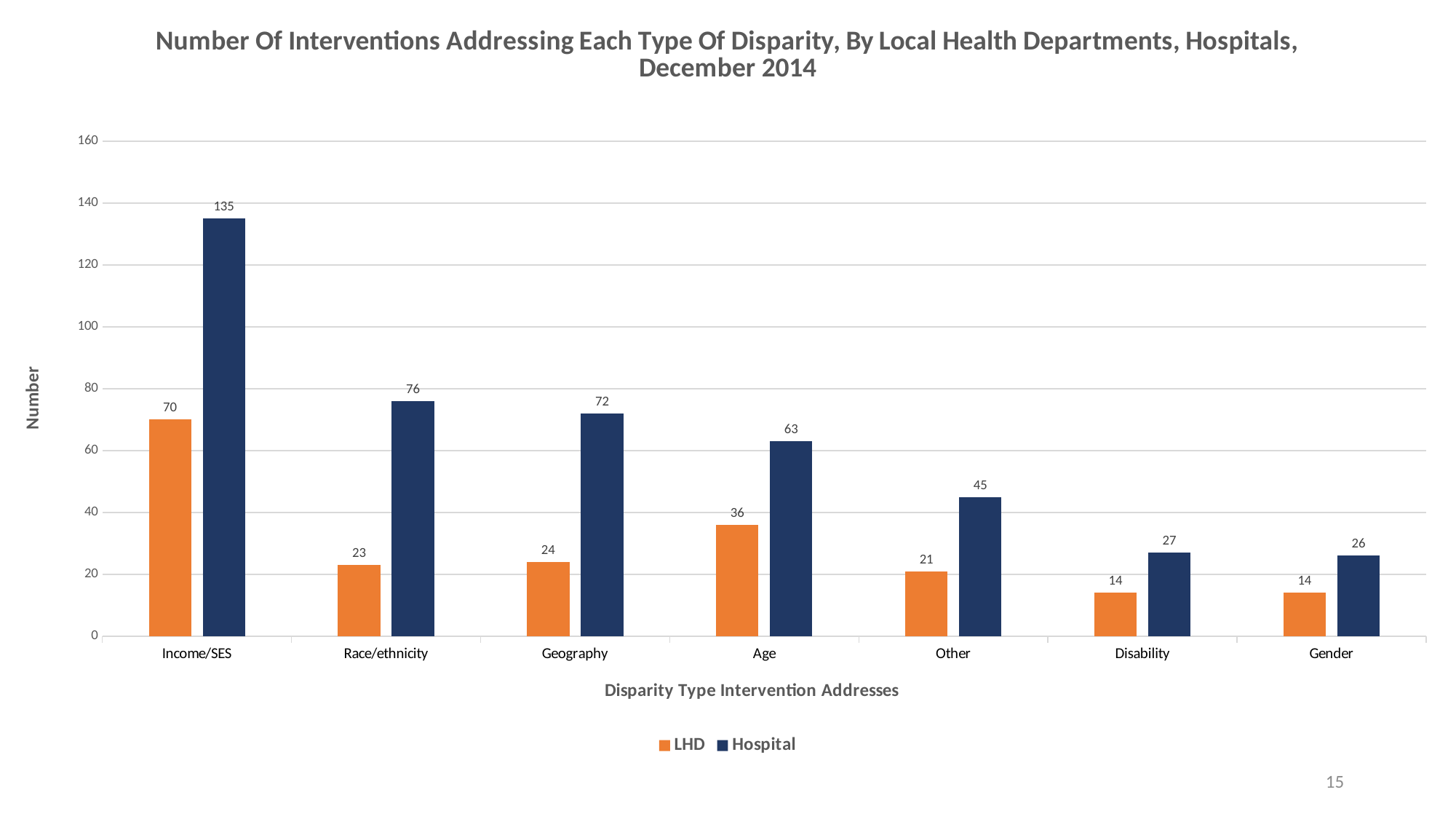
Is the Hospital value for Age greater or less than 60? greater How many series does the legend list? 2 What is the difference between the Hospital and LHD values for Income/SES? 65 What is the LHD value for Age? 36 Which disparity type has the lowest Hospital value? Gender What kind of chart is shown on the slide? bar chart Which disparity type has the highest Hospital value? Income/SES What is the difference between the Hospital values for Race/ethnicity and Geography? 4 What is the LHD value for Disability? 14 Which is larger, the LHD value for Geography or the LHD value for Race/ethnicity? Geography What is the Hospital value for Income/SES? 135 How many disparity types are shown on the x axis? 7